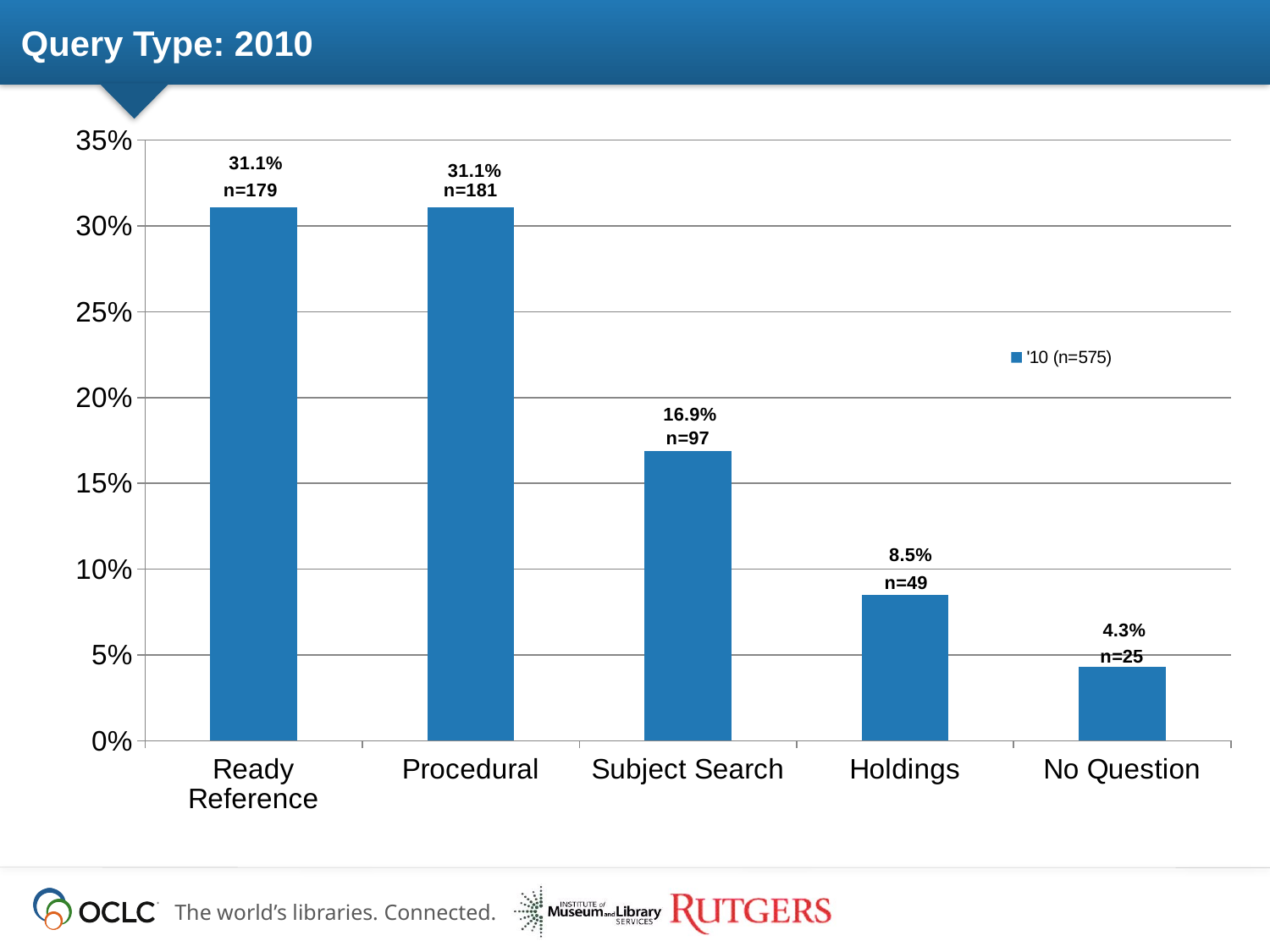
What kind of chart is shown? bar chart What percentage is shown for Subject Search? 16.9% What is the difference in percentage points between Subject Search and Holdings? 8.4 What is the legend entry for the series? '10 (n=575) How many series does the legend list? 1 Which is larger, the percentage for Holdings or for No Question? Holdings What is the n value shown for Procedural? n=181 What percentage is shown for Holdings? 8.5% What is the n value shown for No Question? n=25 How many categories are shown on the x axis? 5 Which category has the lowest percentage? No Question Is the value for Subject Search greater or less than 15%? greater